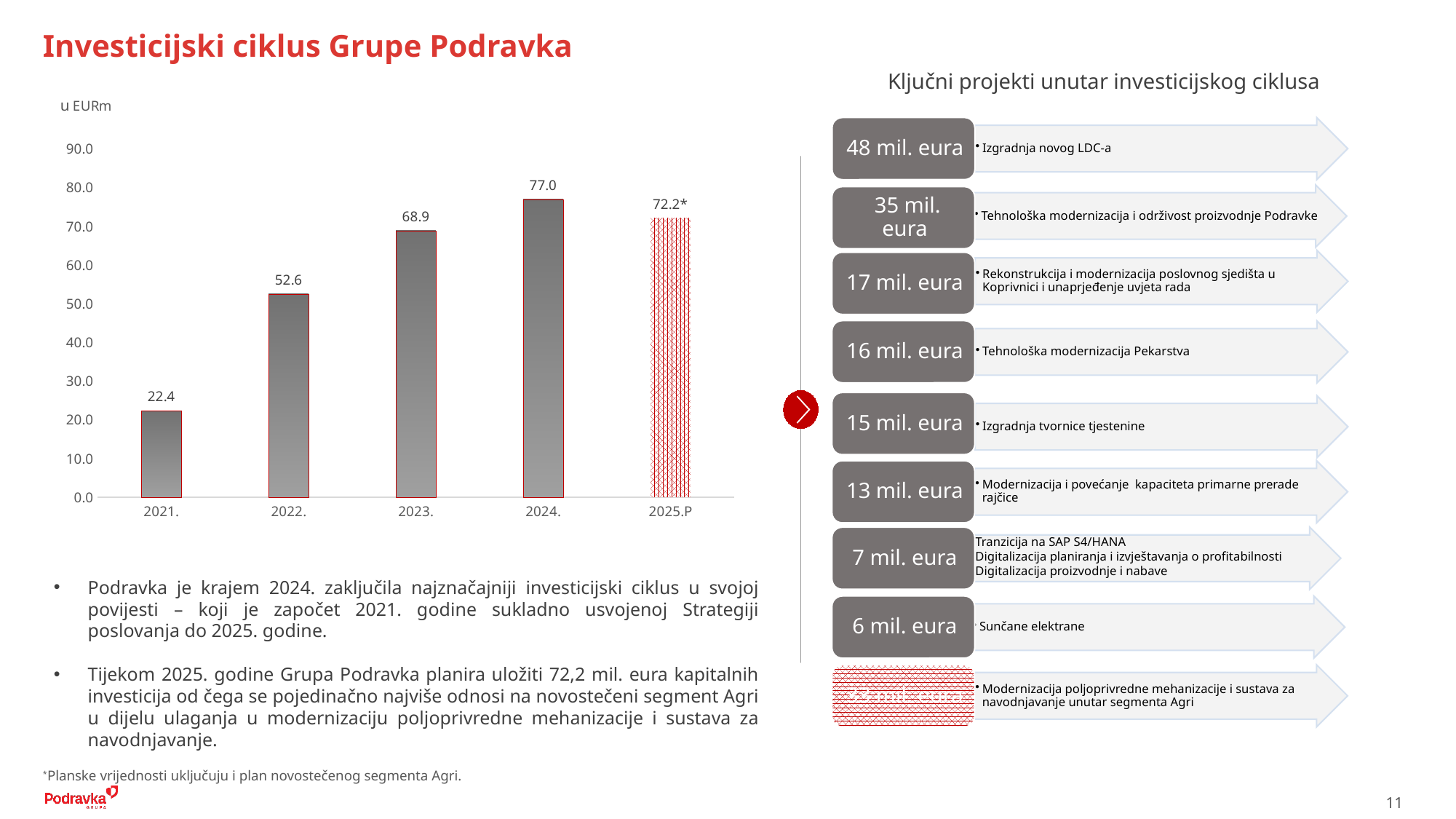
What is the difference between the values for 2022. and 2021. in the bar chart? 30.2 Which year has the lowest value in the bar chart? 2021. What kind of chart is shown on the slide? bar chart How many categories (years) are shown on the x axis of the bar chart? 5 What is the difference between the values for 2024. and 2023. in the bar chart? 8.1 Which is larger in the bar chart, the value for 2024. or the value for 2025.P? 2024. What is the value for 2021. in the bar chart? 22.4 What is the value for 2023. in the bar chart? 68.9 Which year has the highest value in the bar chart? 2024. Is the value for 2022. in the bar chart greater or less than 50.0? greater What unit is indicated above the bar chart's y axis? u EURm What is the value shown for 2025.P in the bar chart? 72.2*